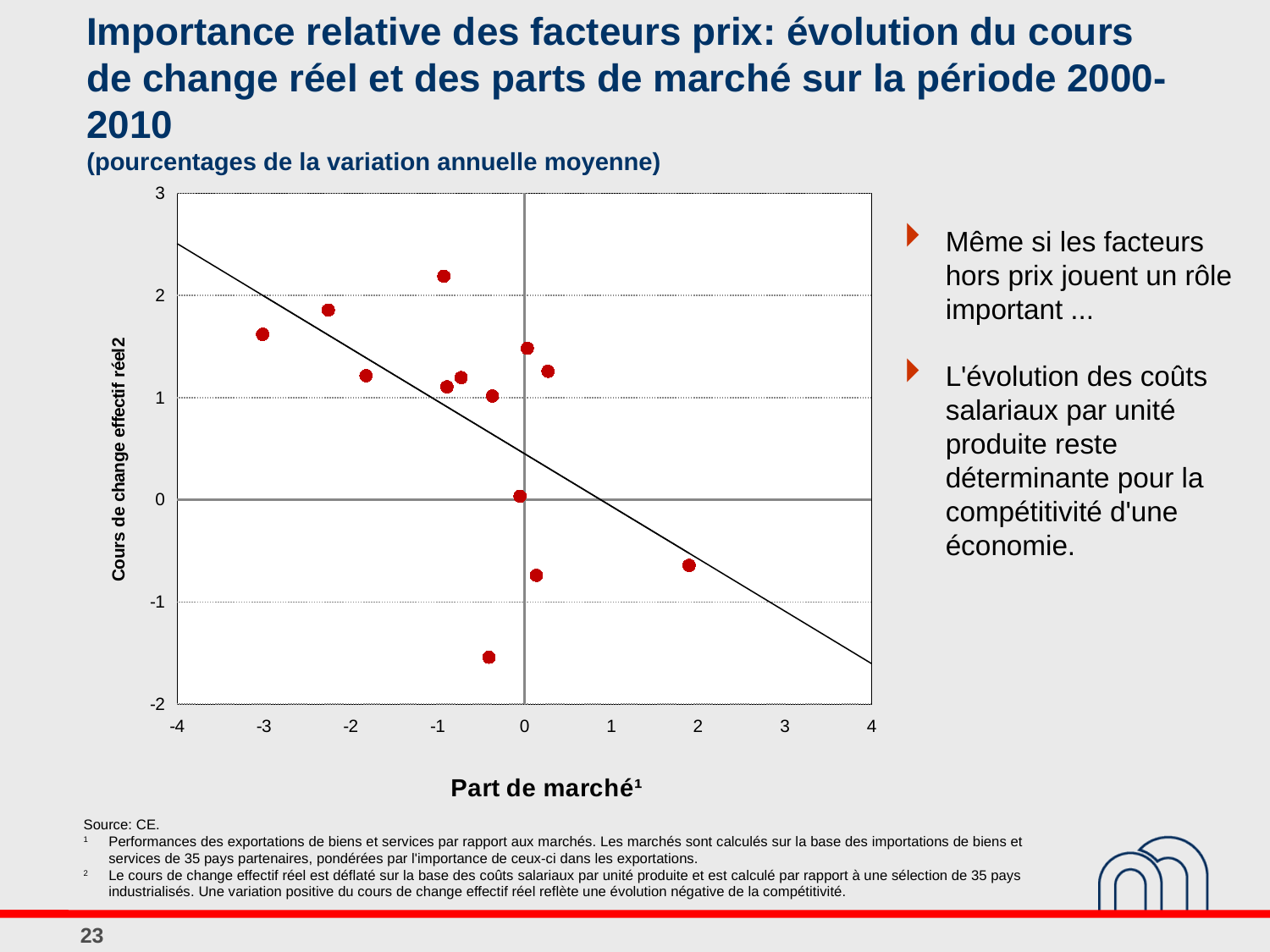
Is the horizontal-axis value of the leftmost point in the chart greater or less than -2? less Are there more data points above the horizontal zero line or below it in the chart? Above Is the vertical-axis value of the lowest point in the chart greater or less than -1? less How many data points are plotted in the chart? 13 What is the title of the vertical axis of the chart? Cours de change effectif réel² What kind of chart is shown on the slide? Scatter plot What is the highest value shown on the horizontal axis of the chart? 4 Does the trend line in the chart rise or fall as the x-axis value increases? Falls What is the lowest value shown on the vertical axis of the chart? -2 Is the horizontal-axis value of the rightmost point in the chart greater or less than 1? greater